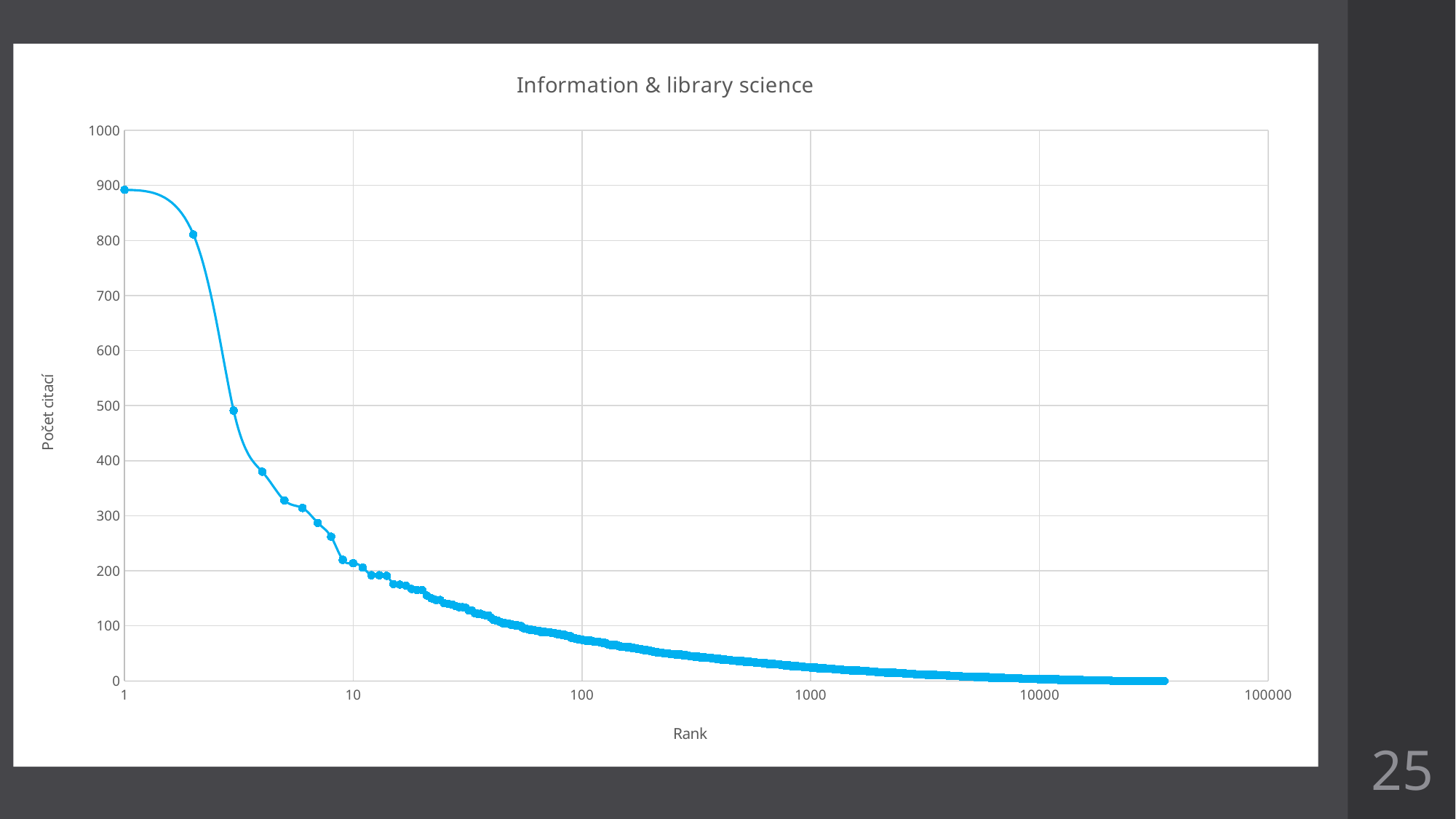
Is the value for rank 1 greater or less than 800? greater Which has more citations, rank 1 or rank 3? rank 1 Is the value for rank 3 greater or less than 400? greater Is the value for rank 4 greater or less than 400? less What is the label of the x axis? Rank What is the title of the chart? Information & library science Which rank has the highest number of citations? 1 What kind of chart is shown on the slide? line chart Do the values rise or fall as rank increases along the x axis? fall